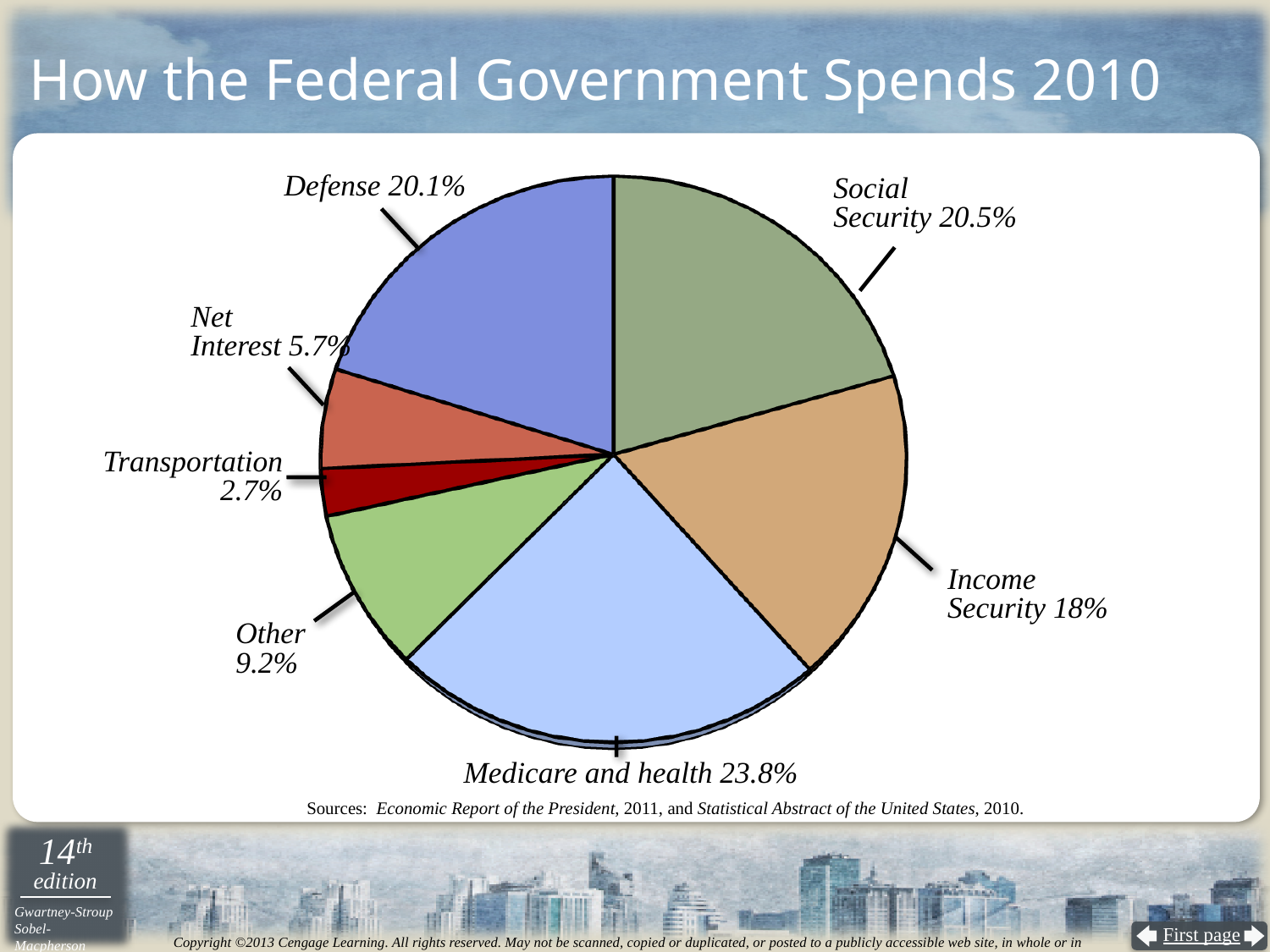
What is the title of the slide? How the Federal Government Spends 2010 What share of federal spending in 2010 goes to Medicare and health? 23.8% What kind of chart is shown on the slide? Pie chart What share of federal spending in 2010 goes to Net Interest? 5.7% What share of federal spending in 2010 goes to Transportation? 2.7% What share of federal spending in 2010 goes to Defense? 20.1% Which category has the largest share of federal spending in 2010? Medicare and health What is the difference in percentage points between Social Security and Income Security? 2.5 Which category has the smallest share of federal spending in 2010? Transportation How many categories are shown in the pie chart? 7 What is the difference in percentage points between Other and Net Interest? 3.5 Which is larger, the share for Defense or the share for Income Security? Defense